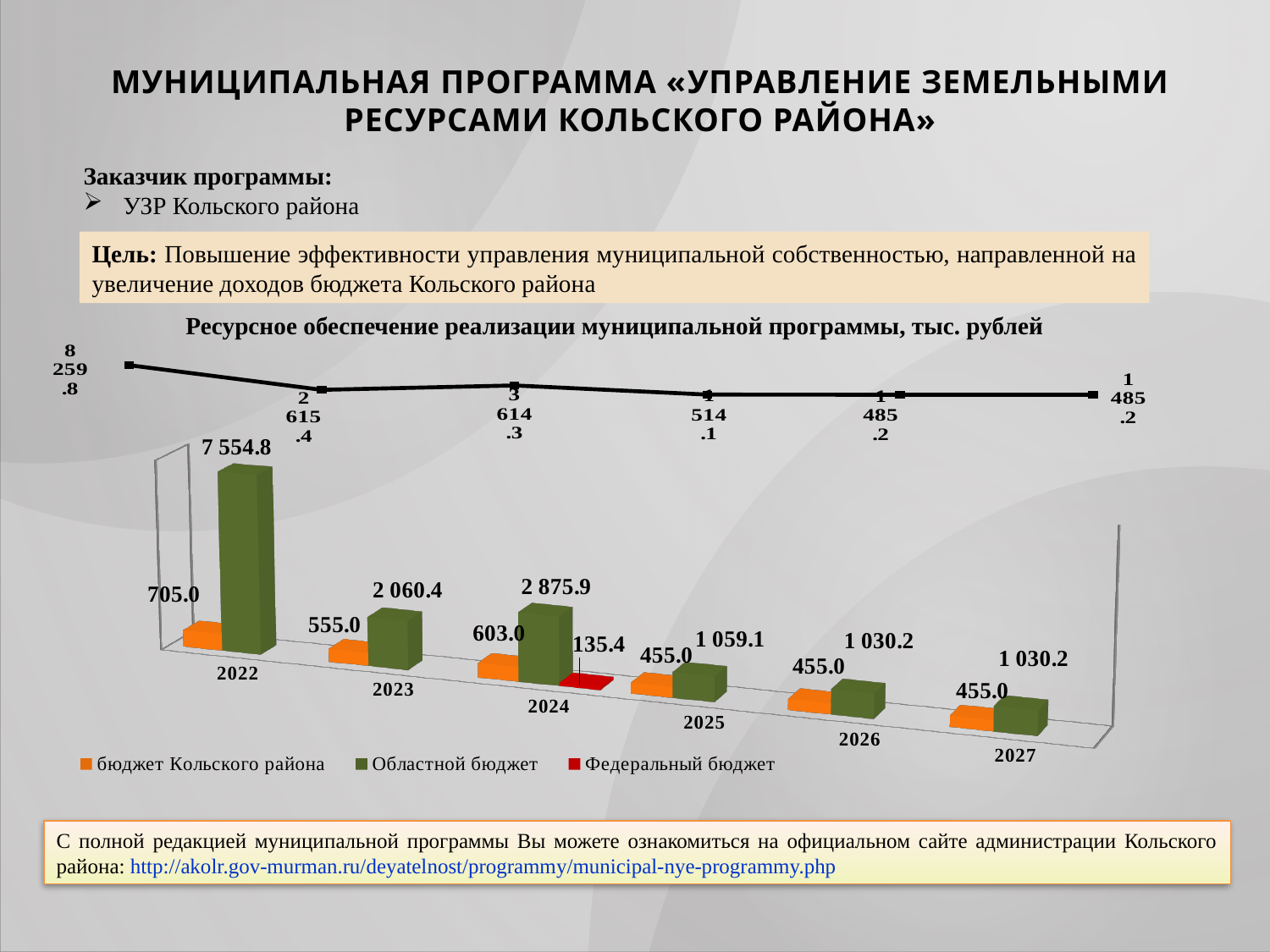
What is the value of Федеральный бюджет for 2024? 135.4 What is the difference between Областной бюджет in 2022 and in 2023? 5 494.4 What is the title of the chart? Ресурсное обеспечение реализации муниципальной программы, тыс. рублей In which year is Областной бюджет the highest? 2022 How many series does the chart legend list? 3 Which is larger: Областной бюджет in 2024 or in 2025? 2024 What is the difference between бюджет Кольского района and Федеральный бюджет in 2024? 467.6 In which year is бюджет Кольского района the highest? 2022 How many years are shown on the x axis of the chart? 6 What value is labelled on the line at 2022? 8 259.8 What is the value of Областной бюджет for 2022? 7 554.8 What is the value of бюджет Кольского района for 2023? 555.0